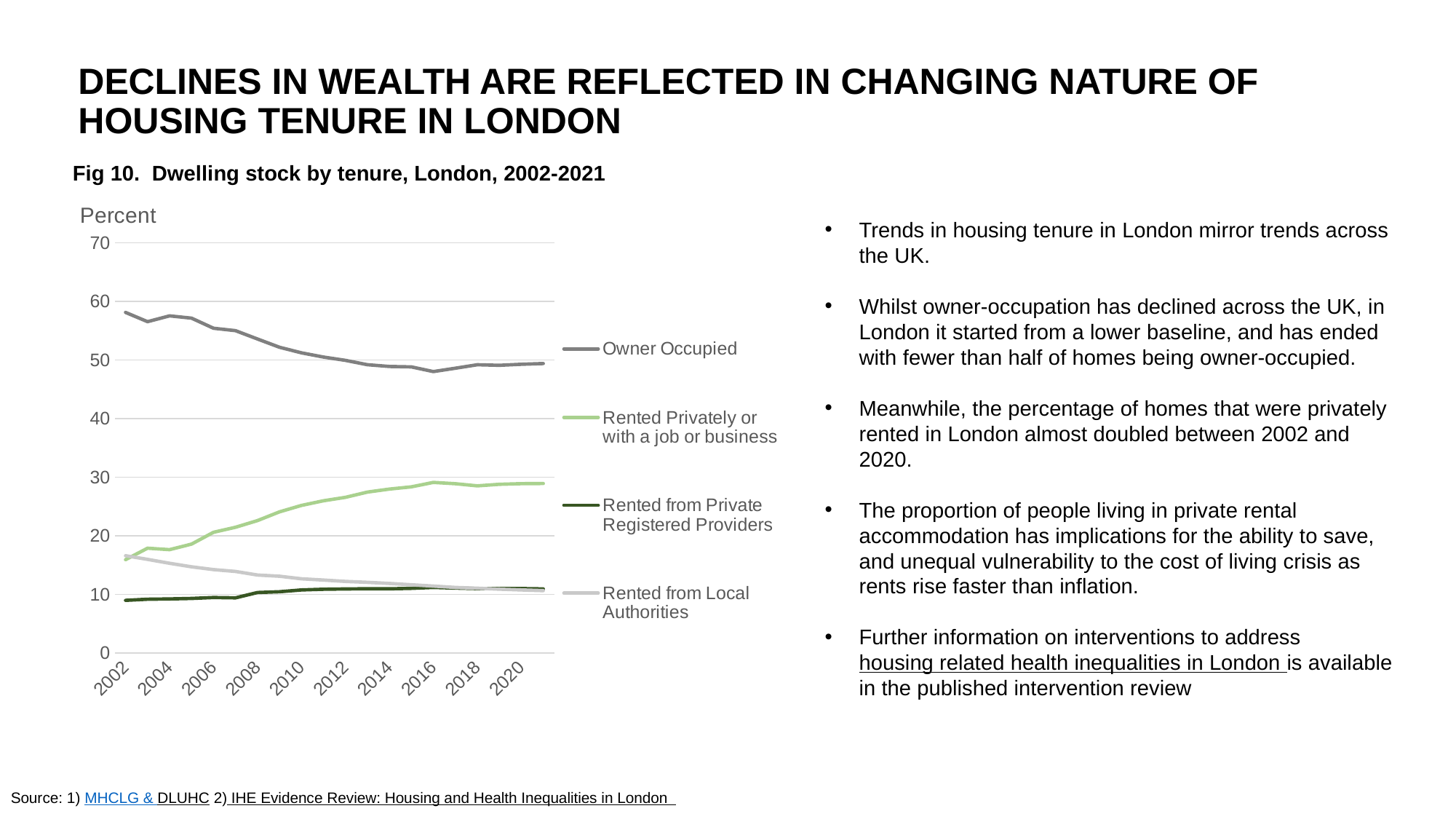
Is the 'Rented from Local Authorities' value in 2002 greater or less than 10? greater Does the 'Rented from Local Authorities' line rise or fall between 2002 and 2020? fall Does the Owner Occupied line rise or fall between 2002 and 2020? fall Is the Owner Occupied value in 2002 greater or less than 60? less How many series does the legend of the chart list? 4 What kind of chart is shown in Fig 10? line chart Which tenure series has the highest value in 2002? Owner Occupied Which tenure series has the lowest value in 2002? Rented from Private Registered Providers Is the Owner Occupied value in 2002 greater or less than 50? greater What is the label on the vertical axis of the chart? Percent Does the 'Rented Privately or with a job or business' line rise or fall between 2002 and 2020? rise